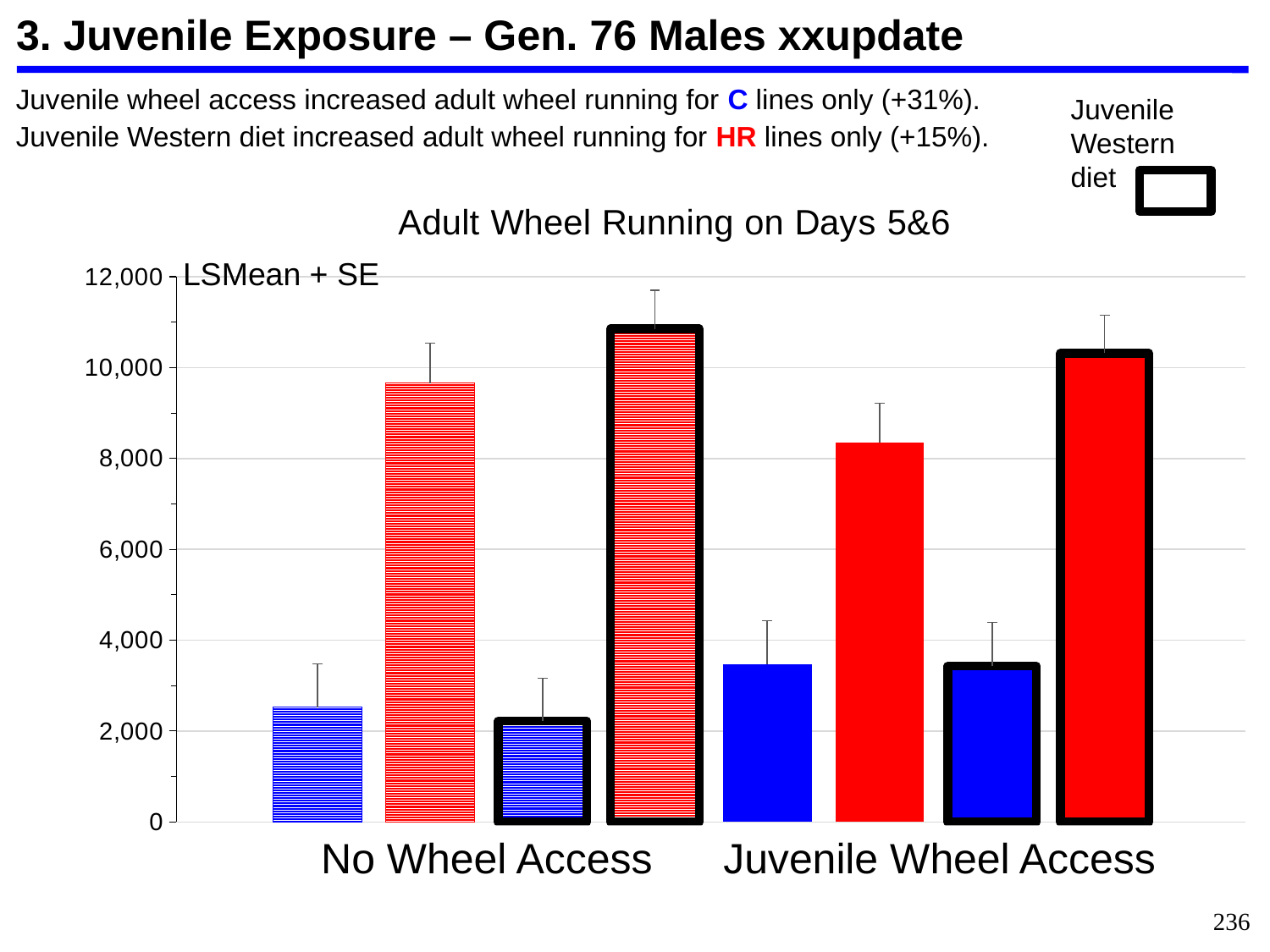
What is the title of the chart? Adult Wheel Running on Days 5&6 Which is larger: the blue bar without a black outline in the No Wheel Access group or the blue bar without a black outline in the Juvenile Wheel Access group? Juvenile Wheel Access How many categories are labelled on the x axis of the chart? 2 In which x-axis group is the tallest bar of the whole chart found? No Wheel Access How many bars are plotted in the No Wheel Access group? 4 Is the value of the solid red bar without a black outline in the Juvenile Wheel Access group greater or less than 10,000? less What kind of chart is shown on the slide? bar chart Which is larger: the red bar without a black outline in the No Wheel Access group or the red bar without a black outline in the Juvenile Wheel Access group? No Wheel Access Is the value of the tallest red bar in the No Wheel Access group greater or less than 10,000? greater Is the value of the first (blue, no outline) bar in the No Wheel Access group greater or less than 4,000? less What does the black outline on a bar indicate, according to the legend box on the slide? Juvenile Western diet